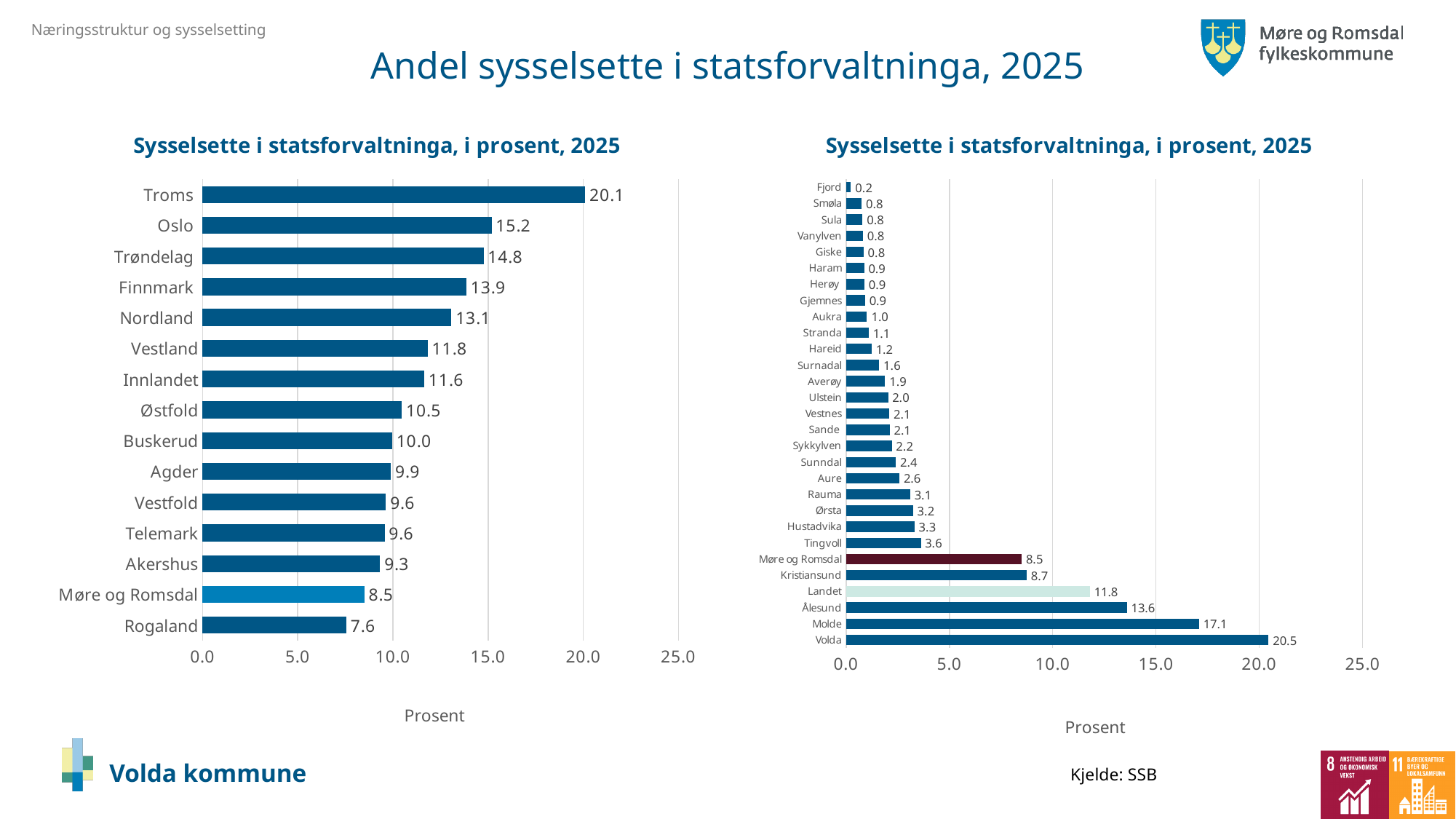
In the left chart, what is the value for Møre og Romsdal? 8.5 In the right chart, what is the value for Volda? 20.5 In the left chart, what is the value for Troms? 20.1 In the left chart, what is the difference between Oslo and Trøndelag? 0.4 In the right chart, what is the value for Landet? 11.8 In the right chart, which is larger, Molde or Ålesund? Molde In the left chart, which category has the lowest value? Rogaland What kind of chart is the right chart? Bar chart In the right chart, which bar is coloured dark red? Møre og Romsdal In the right chart, which category has the lowest value? Fjord In the left chart, how many categories are shown? 15 In the right chart, what is the difference between Volda and Molde? 3.4